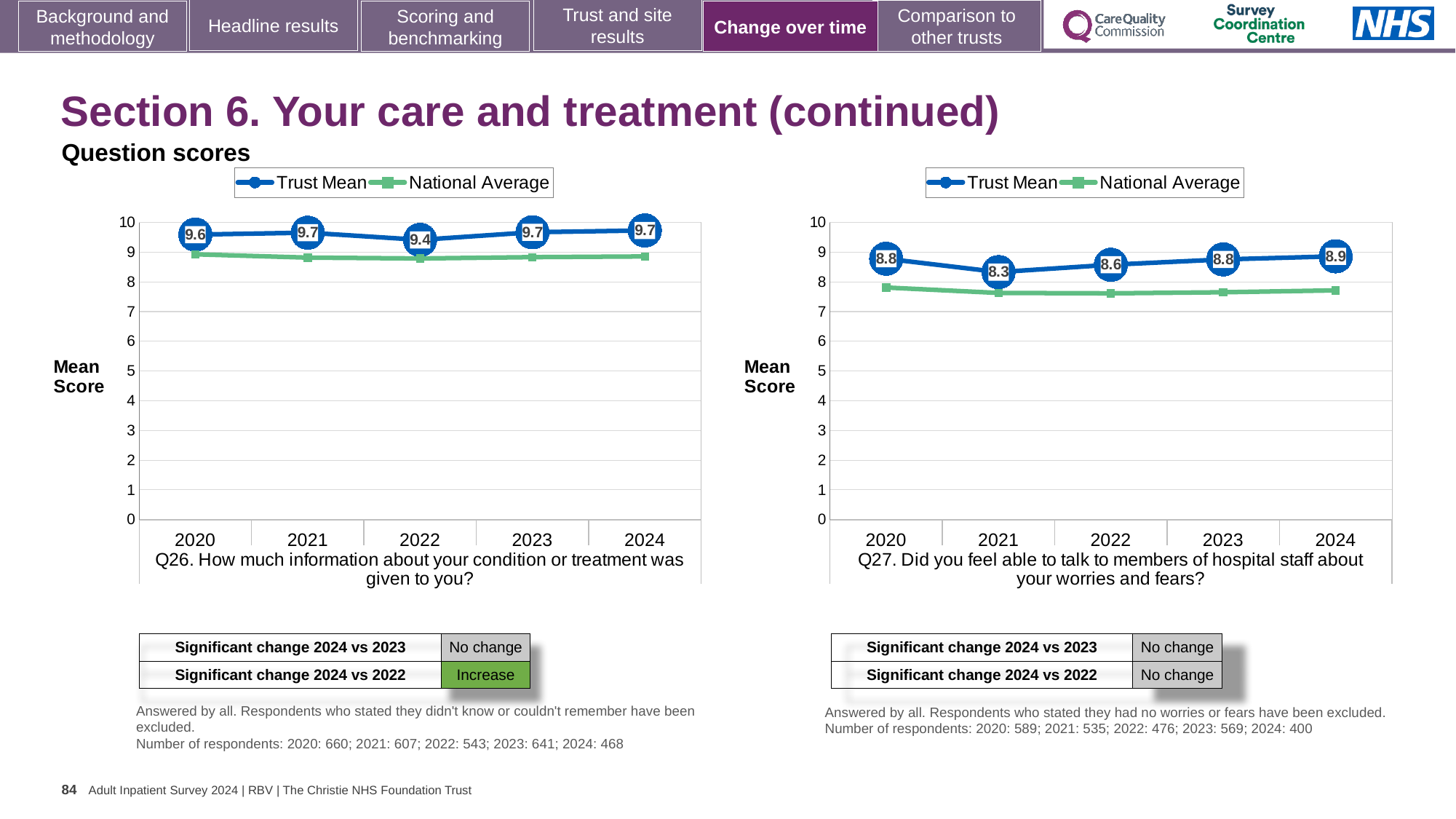
In the Q26 chart (left), is the Trust Mean score for 2020 or 2022 larger? 2020 In the Q26 chart (left), which year has the lowest Trust Mean score? 2022 In the Q27 chart (right), which year has the highest Trust Mean score? 2024 In the Q26 chart (left), is the National Average value for 2024 greater or less than 9? less What type of chart is the Q26 chart (left)? Line chart In the Q27 chart (right), what is the difference between the Trust Mean scores for 2024 and 2021? 0.6 How many series does the legend of the Q27 chart (right) list? 2 In the Q27 chart (right), what is the Trust Mean score for 2024? 8.9 In the Q26 chart (left), what is the Trust Mean score for 2022? 9.4 In the Q27 chart (right), which year has the lowest Trust Mean score? 2021 In the Q27 chart (right), is the National Average value for 2022 greater or less than 8? less How many years are plotted on the x axis of the Q26 chart (left)? 5